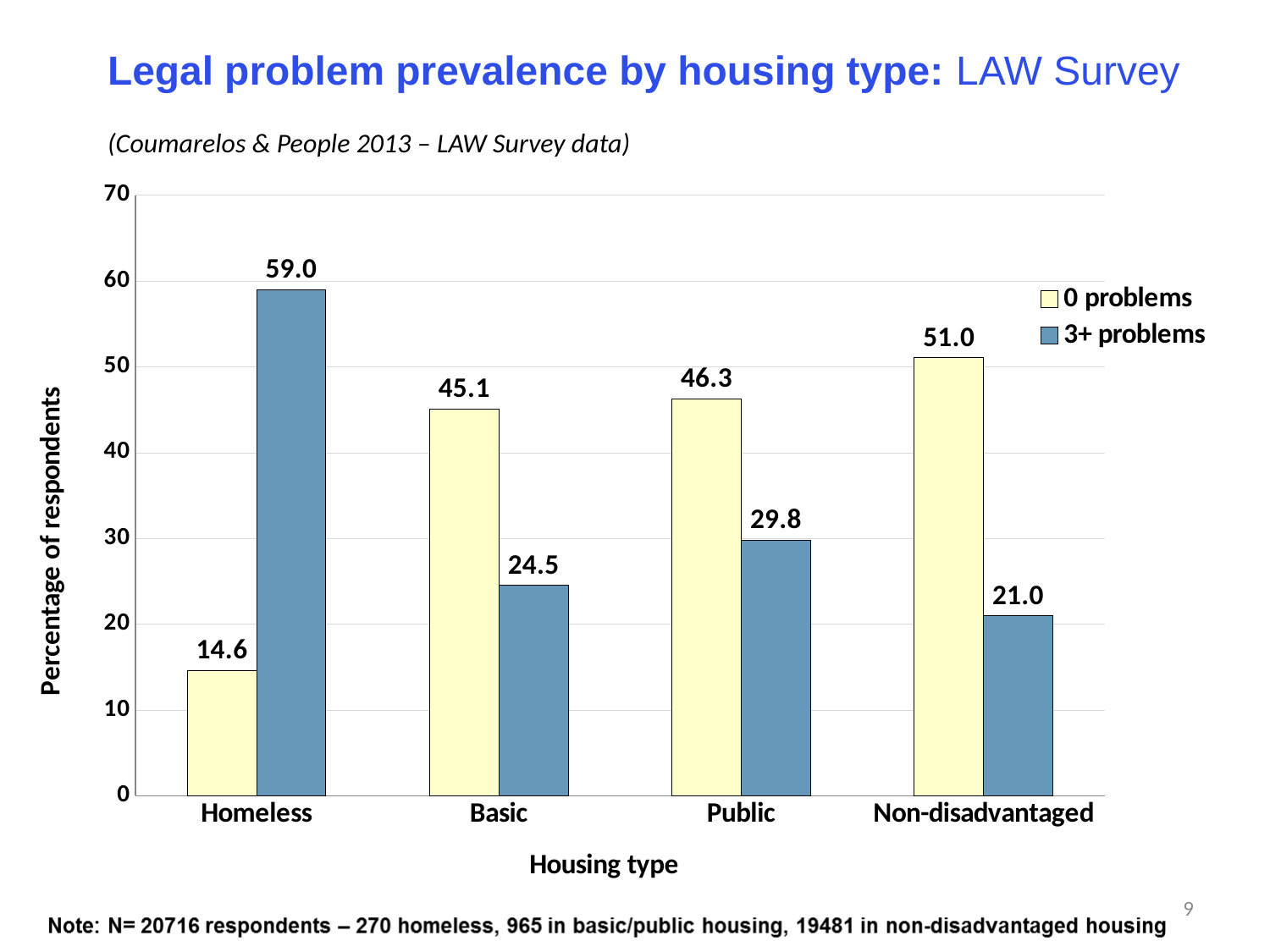
Which is larger: the 3+ problems value for Basic housing or for Public housing? Public What is the label of the y axis? Percentage of respondents Which housing type has the lowest percentage of respondents with 0 problems? Homeless How many series does the legend list? 2 Which housing type has the highest percentage of respondents with 3+ problems? Homeless What is the difference between the 3+ problems and 0 problems values for the Homeless category? 44.4 What kind of chart is shown on the slide? Bar chart How many housing types are shown on the x axis? 4 What percentage of non-disadvantaged respondents had 0 problems? 51.0 What is the value for 3+ problems in the Public housing category? 29.8 What is the difference between the 0 problems values for Non-disadvantaged and Basic housing? 5.9 What percentage of homeless respondents had 3+ problems? 59.0